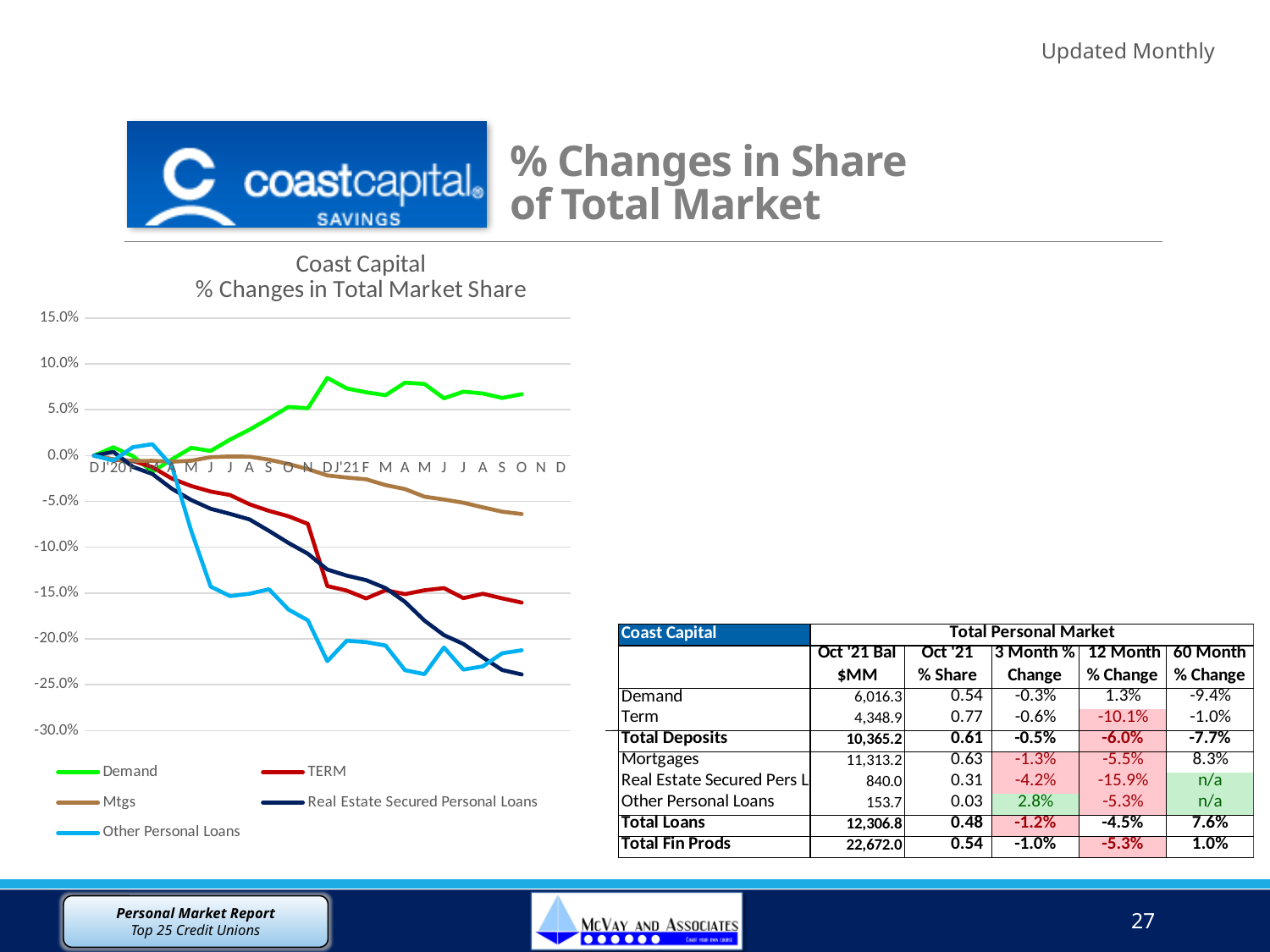
What kind of chart is shown on the slide? line chart Which colour is used for the Demand line in the chart? green What is the title of the chart? Coast Capital % Changes in Total Market Share Does the Mtgs line generally rise or fall from left to right across the chart? fall How many series does the chart's legend list? 5